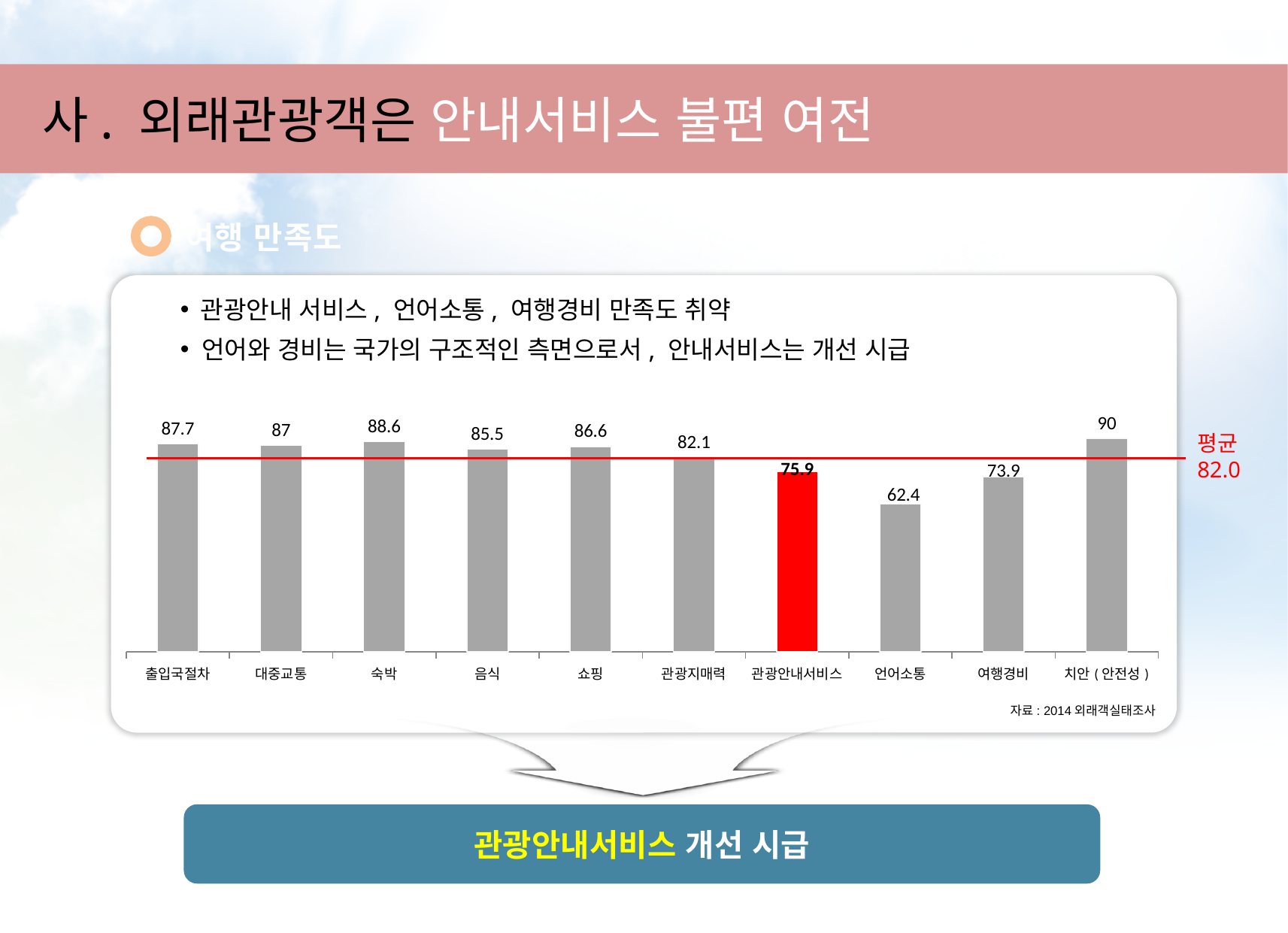
What average value (평균) is marked by the red line on the chart? 82.0 Which bar is highlighted in red? 관광안내서비스 What is the difference between the values for 치안 (안전성) and 언어소통? 27.6 What is the value for 관광안내서비스? 75.9 Which category has the lowest value? 언어소통 Which is larger, the value for 여행경비 or the value for 관광지매력? 관광지매력 Which category has the highest value? 치안 (안전성) What is the value for 치안 (안전성)? 90 What is the difference between the values for 숙박 and 관광안내서비스? 12.7 What kind of chart is shown on the slide? Bar chart How many categories are shown in the chart? 10 What is the value for 언어소통? 62.4